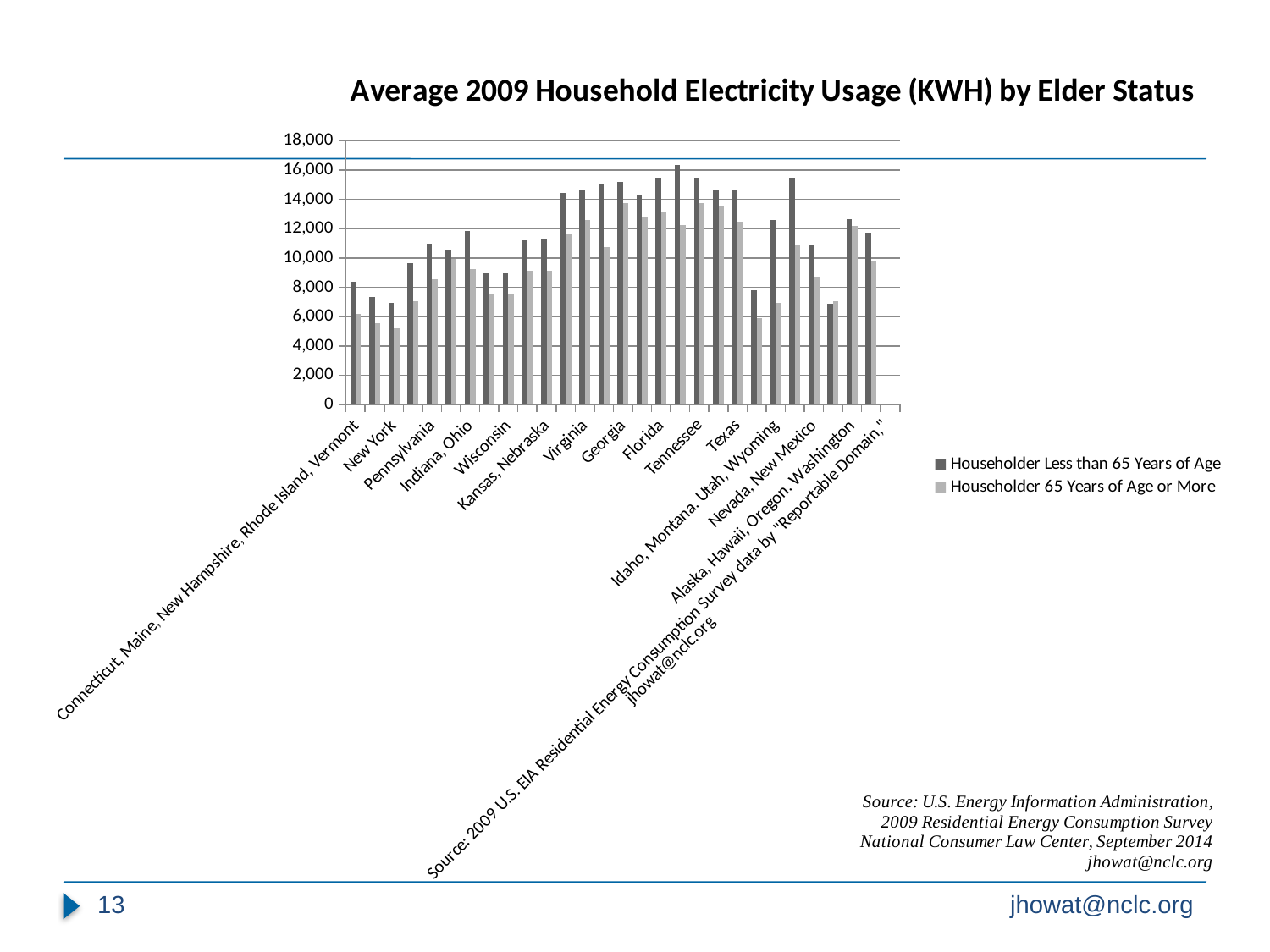
What is the title of the chart? Average 2009 Household Electricity Usage (KWH) by Elder Status What kind of chart is shown on the slide? bar chart Which legend entry is shown in the darker grey colour? Householder Less than 65 Years of Age What is the highest value shown on the vertical axis? 18,000 Which series has the tallest bar on the chart? Householder Less than 65 Years of Age How many series does the legend list? 2 For Connecticut, Maine, New Hampshire, Rhode Island, Vermont, which series has the larger value: Householder Less than 65 Years of Age or Householder 65 Years of Age or More? Householder Less than 65 Years of Age Is the value for Householder 65 Years of Age or More in Connecticut, Maine, New Hampshire, Rhode Island, Vermont greater or less than 8,000? less Is any bar on the chart greater than 18,000? No Is the tallest bar on the chart greater or less than 14,000? greater